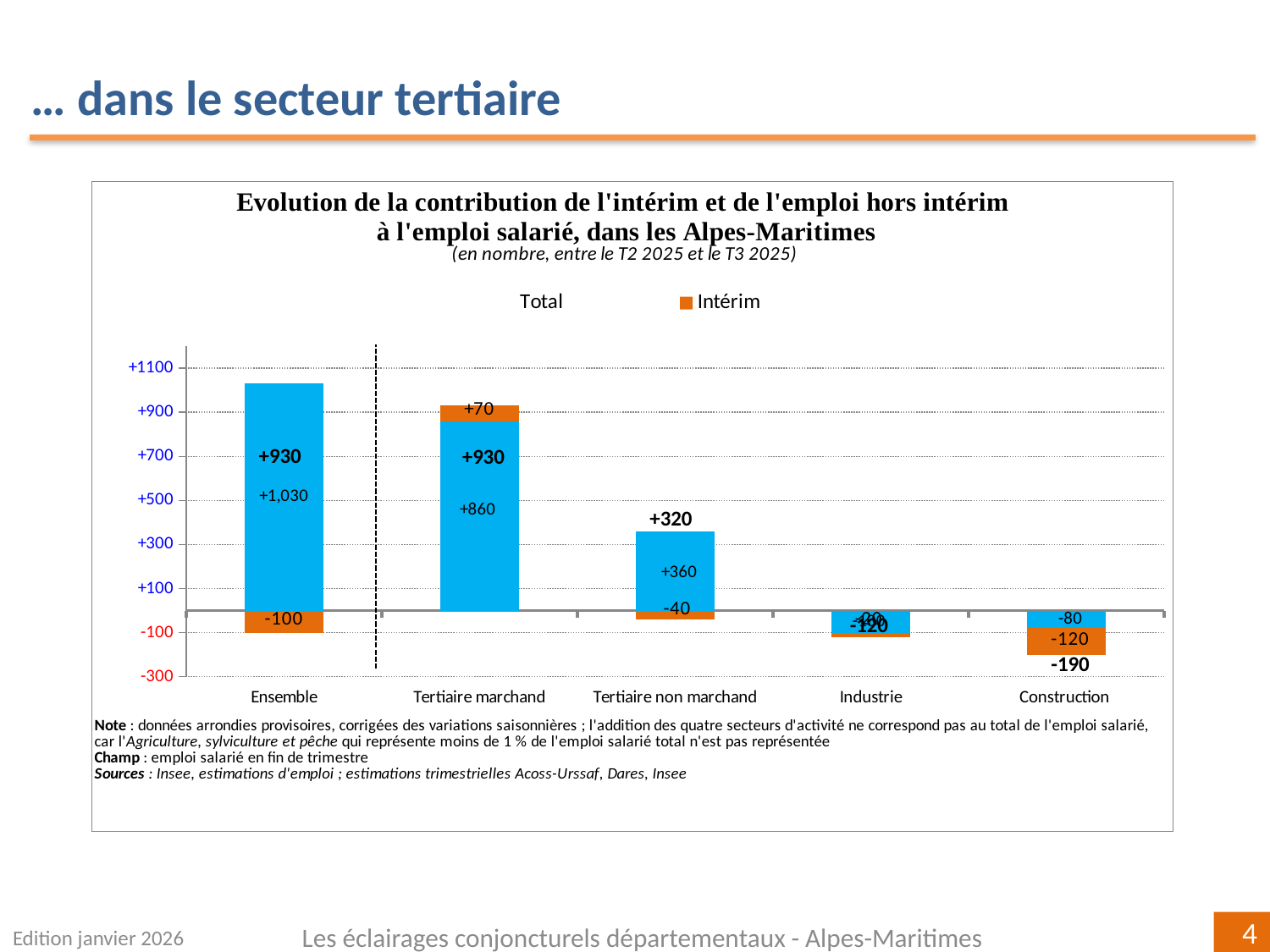
How many categories are shown on the x axis of the chart? 5 What is the Intérim value for Ensemble? -100 Which colour represents the Intérim series in the legend? orange What value is printed on the blue bar for Tertiaire marchand? +860 Which category has the lowest bold total value? Construction What is the Intérim value for Tertiaire marchand? +70 Which has the larger Intérim value, Tertiaire marchand or Tertiaire non marchand? Tertiaire marchand What is the bold total value shown for Construction? -190 What is the bold total value shown for Tertiaire non marchand? +320 What kind of chart is shown on the slide? bar chart How many series does the chart legend list? 2 What is the difference between the blue bar value for Ensemble (+1,030) and the blue bar value for Tertiaire marchand (+860)? 170